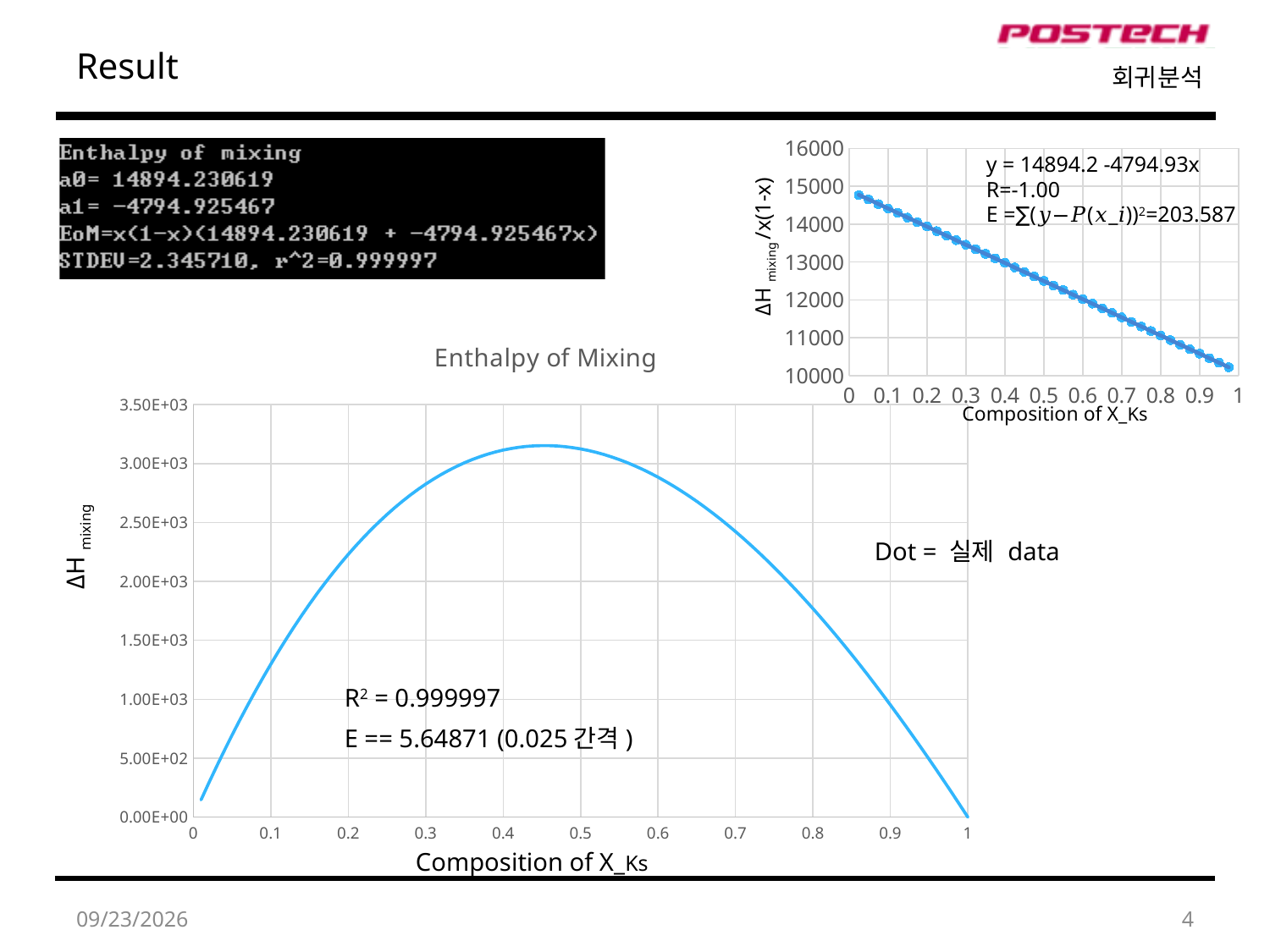
What R² value is printed on the 'Enthalpy of Mixing' chart? 0.999997 In the top-right chart, is the value at Composition of X_Ks = 0.5 greater or less than 13000? less In the top-right chart, do the plotted values rise or fall as Composition of X_Ks increases? fall In the 'Enthalpy of Mixing' chart, is the value at Composition of X_Ks = 0.3 greater or less than 2.50E+03? greater In the top-right chart, which has the larger value: Composition of X_Ks = 0.2 or Composition of X_Ks = 0.8? 0.2 In the top-right chart, is the value at Composition of X_Ks = 0.1 greater or less than 14000? greater In the 'Enthalpy of Mixing' chart, how does the value change as Composition of X_Ks increases from 0 to 1? rises then falls What is the x-axis label of the 'Enthalpy of Mixing' chart? Composition of X_Ks What kind of chart is the large 'Enthalpy of Mixing' chart at the bottom left? line chart